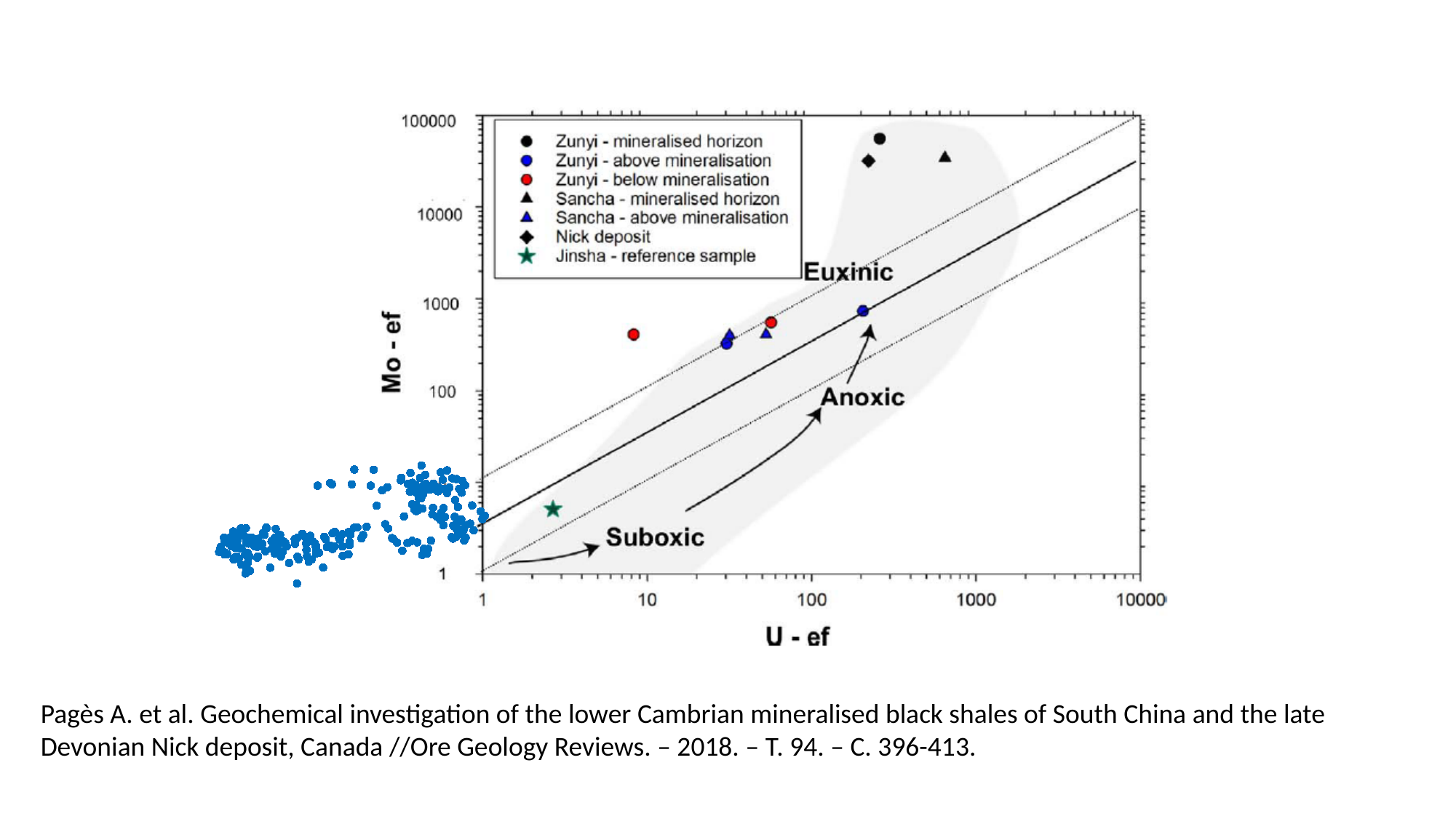
Which series has the point with the highest Mo-ef value? Zunyi - mineralised horizon Which series has the point with the lowest Mo-ef value? Jinsha - reference sample Is the U-ef value for the Sancha - mineralised horizon point greater or less than 100? greater Is the Mo-ef value for the Nick deposit point greater or less than 10000? greater What kind of chart is shown on the slide? Scatter plot What is the label of the y axis of the chart? Mo - ef Is the Mo-ef value for the Jinsha - reference sample point greater or less than 10? less Which has a higher Mo-ef value, the Jinsha - reference sample point or the Nick deposit point? Nick deposit How many Zunyi - below mineralisation points are plotted on the chart? 2 What is the label of the x axis of the chart? U - ef How many series does the legend of the chart list? 7